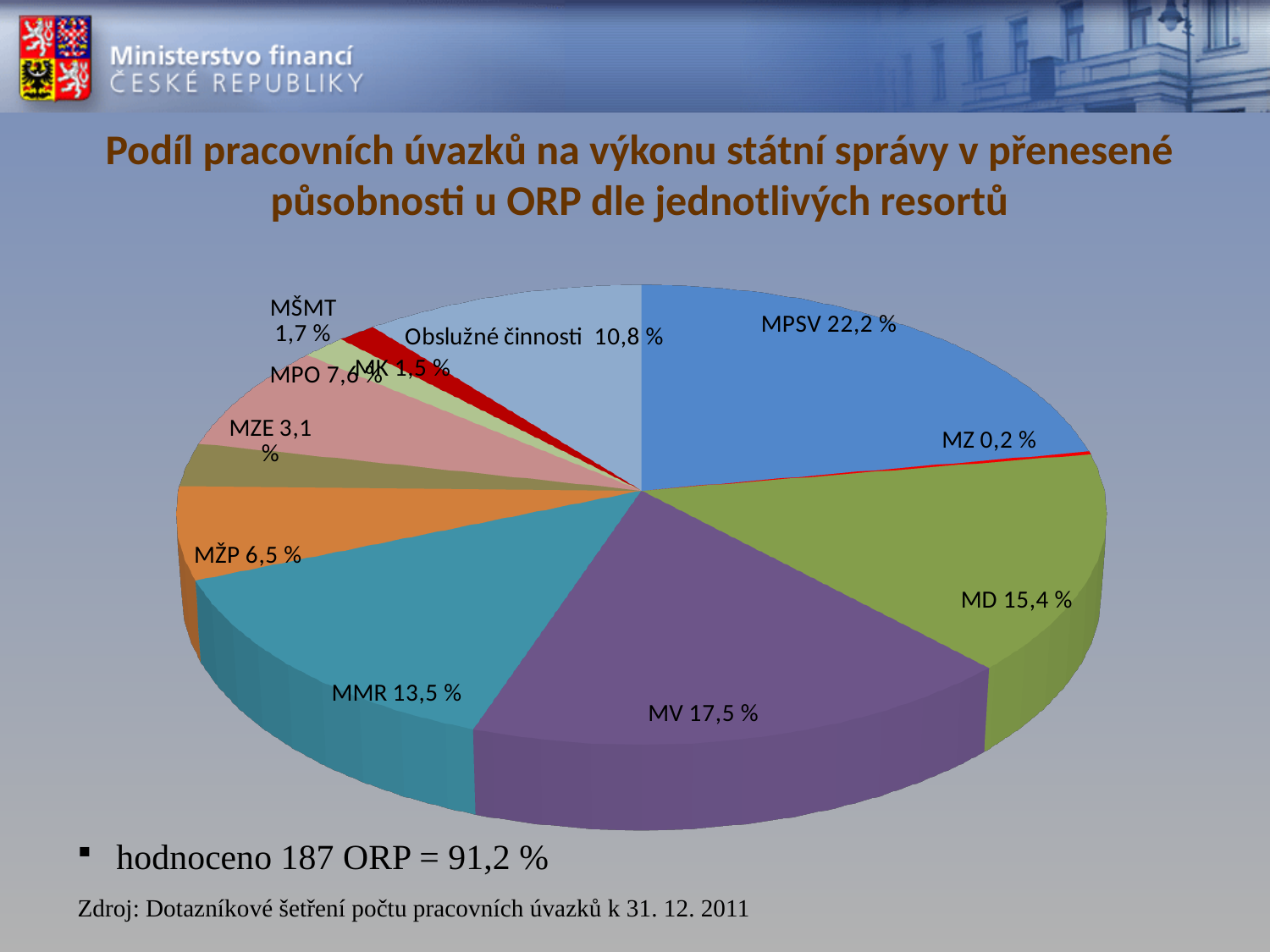
What share does MD have in the pie chart? 15,4 % What kind of chart is shown on the slide? pie chart Which category has the largest share in the pie chart? MPSV What share does MPSV have in the pie chart? 22,2 % What is the share of MŽP in the pie chart? 6,5 % Which category has the smallest share in the pie chart? MZ What share does MV have in the pie chart? 17,5 % What is the difference between the shares of MV and MD? 2,1 % What share does Obslužné činnosti have in the pie chart? 10,8 % How many slices does the pie chart have? 11 Which has a larger share, MD or MMR? MD What is the difference between the shares of MPSV and MV? 4,7 %